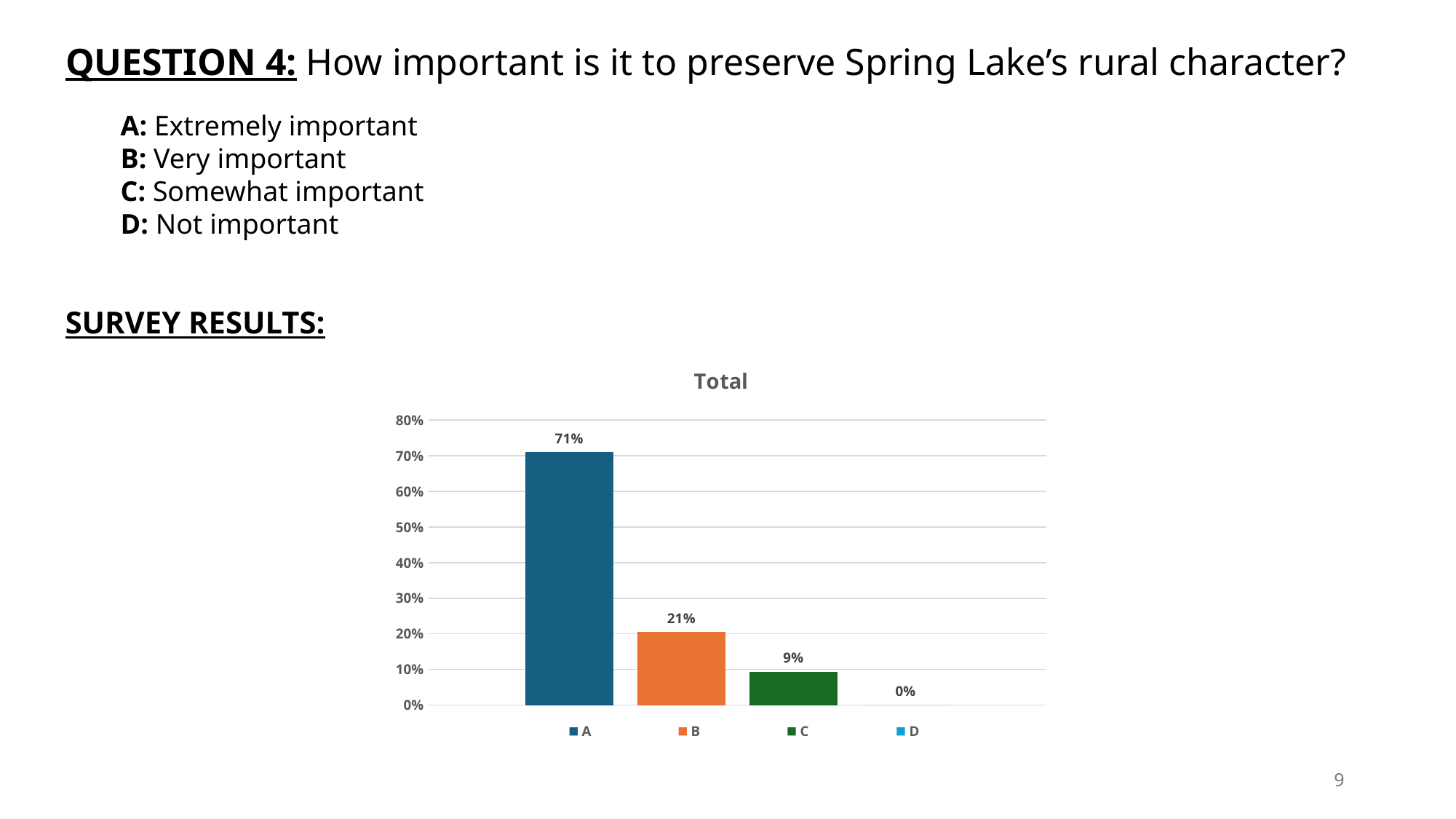
What is the title of the chart? Total What is the difference between the values for A and B? 50% What is the value for D in the chart? 0% Which is larger, the value for B or the value for C? B What kind of chart is shown on the slide? bar chart Which category has the highest value in the chart? A What is the value for B in the chart? 21% How many categories are shown in the chart? 4 What is the value for A in the chart? 71% Which category has the lowest value in the chart? D What is the value for C in the chart? 9% Is the value for A greater or less than 60%? greater